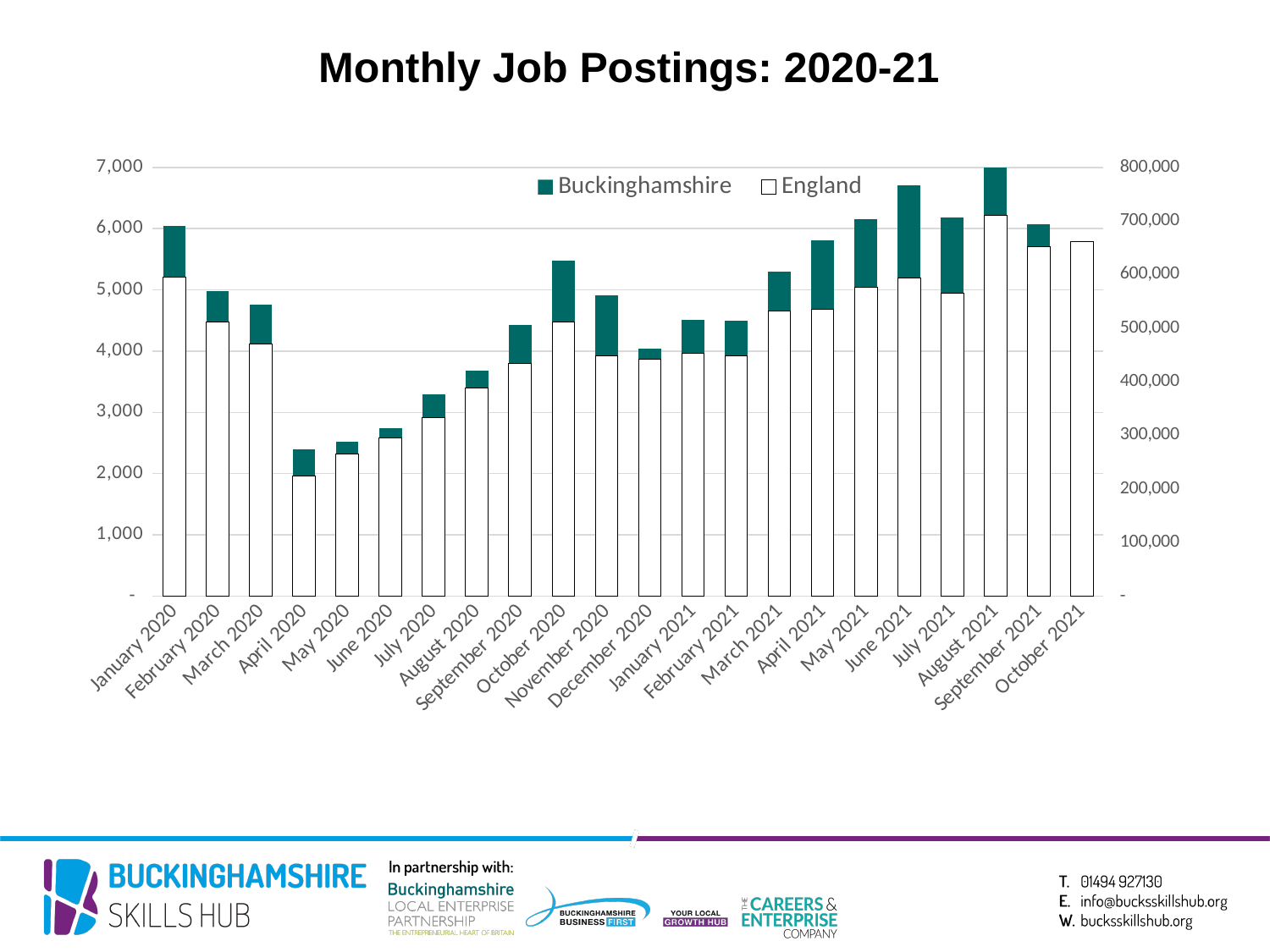
Is the total bar height for April 2020 greater or less than 3,000 on the left axis? less Is the total bar height for June 2021 greater or less than 6,000 on the left axis? greater How many series does the legend list? 2 What type of chart is shown on the slide? Bar chart Is the total bar height for January 2020 greater or less than 5,000 on the left axis? greater How many months are shown along the x axis? 22 Which series is shown in the dark teal colour? Buckinghamshire Which bar is taller, October 2020 or November 2020? October 2020 Which month has the shortest white (England) portion of its bar? April 2020 Which month has the tallest bar? August 2021 What is the title of the chart? Monthly Job Postings: 2020-21 Do the bars rise or fall from April 2020 to October 2020? Rise